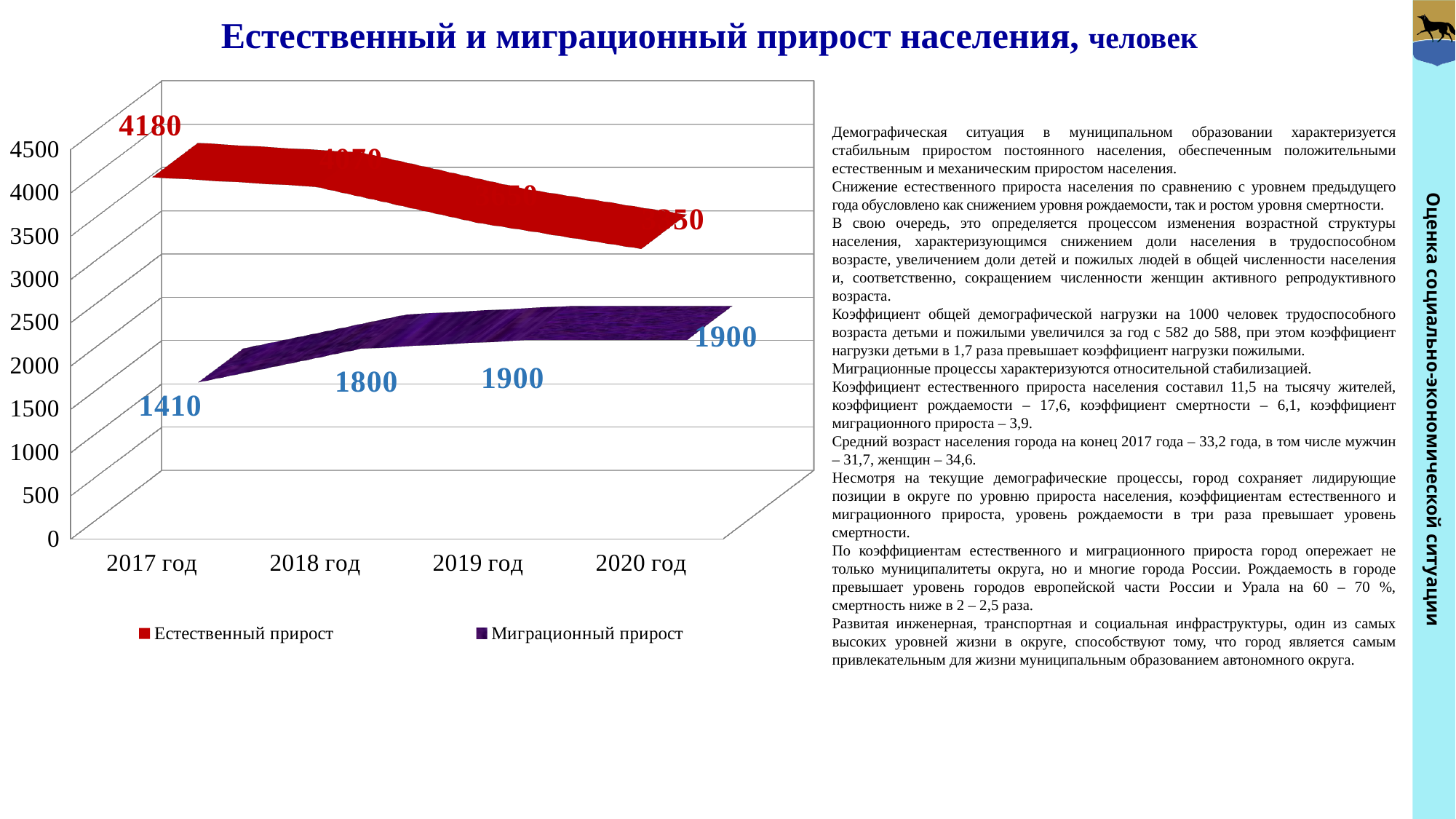
What is the value of Миграционный прирост for 2018 год? 1800 In which year is Естественный прирост the highest? 2017 год What kind of chart is shown on the slide? 3D line chart What is the value of Естественный прирост for 2017 год? 4180 How many years are shown on the x axis? 4 By how much did Миграционный прирост increase from 2017 год to 2018 год? 390 In which year is Миграционный прирост the lowest? 2017 год Is the value of Естественный прирост for 2020 год greater or less than 4000? less What is the value of Миграционный прирост for 2020 год? 1900 What is the value of Миграционный прирост for 2017 год? 1410 Which is larger in 2017 год: Естественный прирост or Миграционный прирост? Естественный прирост How many series does the legend list? 2